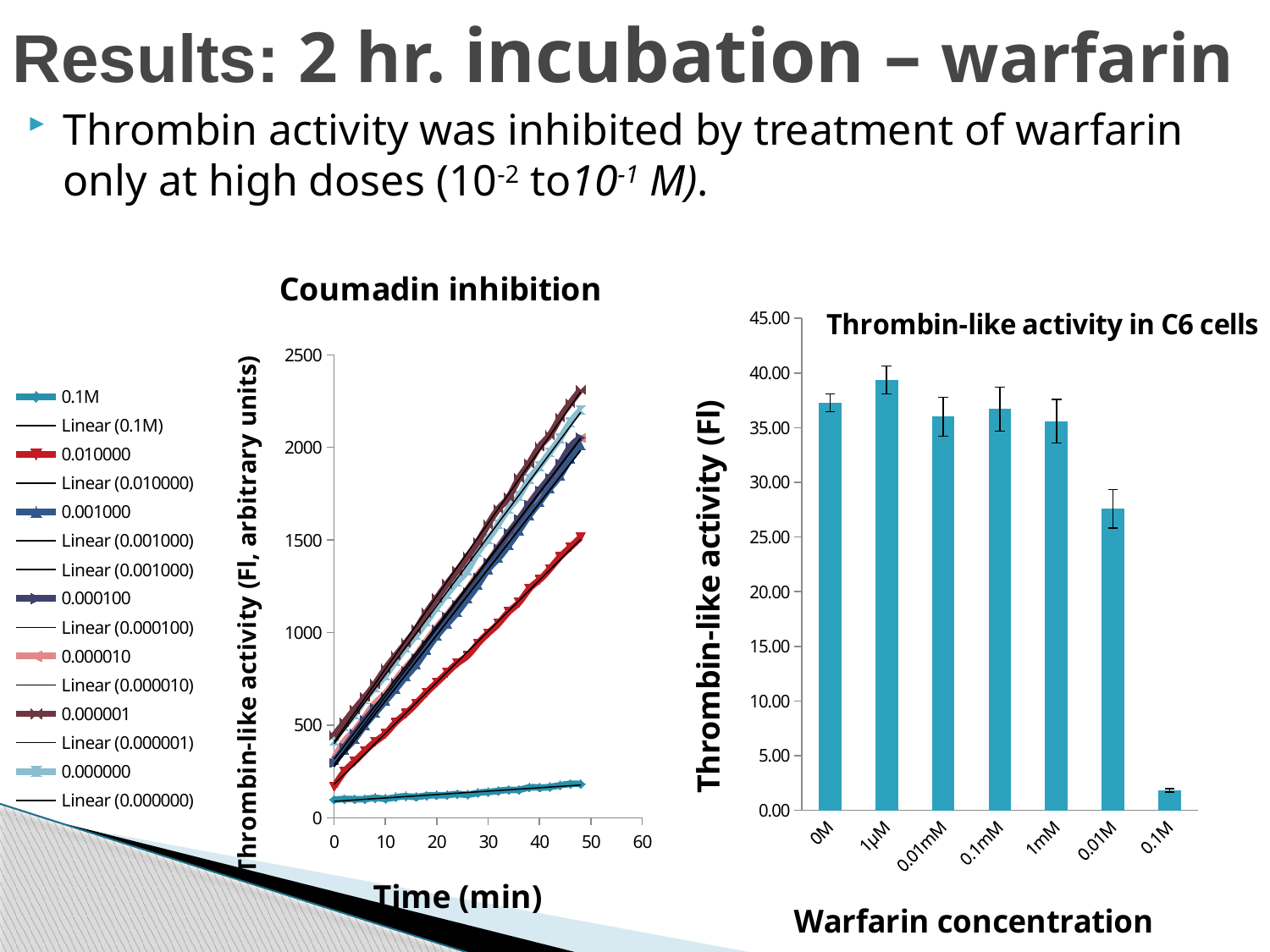
In the 'Thrombin-like activity in C6 cells' chart, is the value for 0M greater or less than 35.00? greater In the 'Thrombin-like activity in C6 cells' chart, how many warfarin concentration categories are shown? 7 What is the x-axis label of the 'Thrombin-like activity in C6 cells' chart? Warfarin concentration What type of chart is the 'Coumadin inhibition' chart? line chart In the 'Thrombin-like activity in C6 cells' chart, which warfarin concentration has the highest thrombin-like activity? 1μM What type of chart is the 'Thrombin-like activity in C6 cells' chart? bar chart In the 'Coumadin inhibition' chart, do the plotted values rise or fall as time increases? rise In the 'Thrombin-like activity in C6 cells' chart, is the value for 0.01M greater or less than 30.00? less In the 'Thrombin-like activity in C6 cells' chart, is the value for 0.1M greater or less than 5.00? less In the 'Thrombin-like activity in C6 cells' chart, which is larger, the value for 0.01M or the value for 0.1M? 0.01M In the 'Coumadin inhibition' chart, which series has the lowest thrombin-like activity across the time course? 0.1M In the 'Thrombin-like activity in C6 cells' chart, which warfarin concentration has the lowest thrombin-like activity? 0.1M